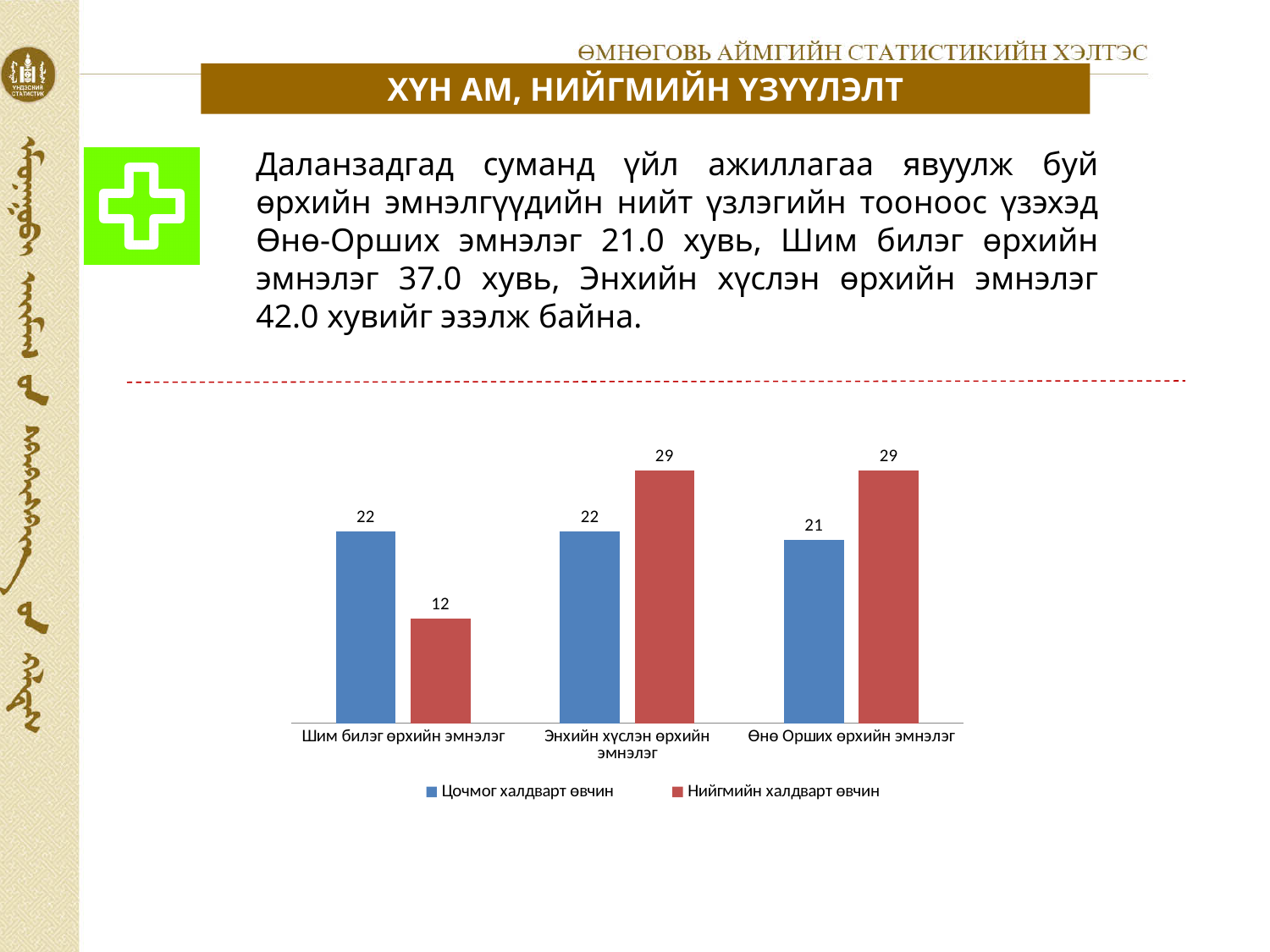
How many series does the legend list? 2 What is the value of Нийгмийн халдварт өвчин for Энхийн хүслэн өрхийн эмнэлэг? 29 For Энхийн хүслэн өрхийн эмнэлэг, which series has the larger value: Цочмог халдварт өвчин or Нийгмийн халдварт өвчин? Нийгмийн халдварт өвчин Which category has the lowest value for Цочмог халдварт өвчин? Өнө Орших өрхийн эмнэлэг What is the value of Нийгмийн халдварт өвчин for Шим билэг өрхийн эмнэлэг? 12 What is the difference between Цочмог халдварт өвчин and Нийгмийн халдварт өвчин for Шим билэг өрхийн эмнэлэг? 10 What is the value of Цочмог халдварт өвчин for Өнө Орших өрхийн эмнэлэг? 21 What is the difference between Нийгмийн халдварт өвчин and Цочмог халдварт өвчин for Өнө Орших өрхийн эмнэлэг? 8 How many categories are shown on the x axis of the chart? 3 What is the value of Цочмог халдварт өвчин for Шим билэг өрхийн эмнэлэг? 22 What kind of chart is shown on the slide? Bar chart Which category has the lowest value for Нийгмийн халдварт өвчин? Шим билэг өрхийн эмнэлэг